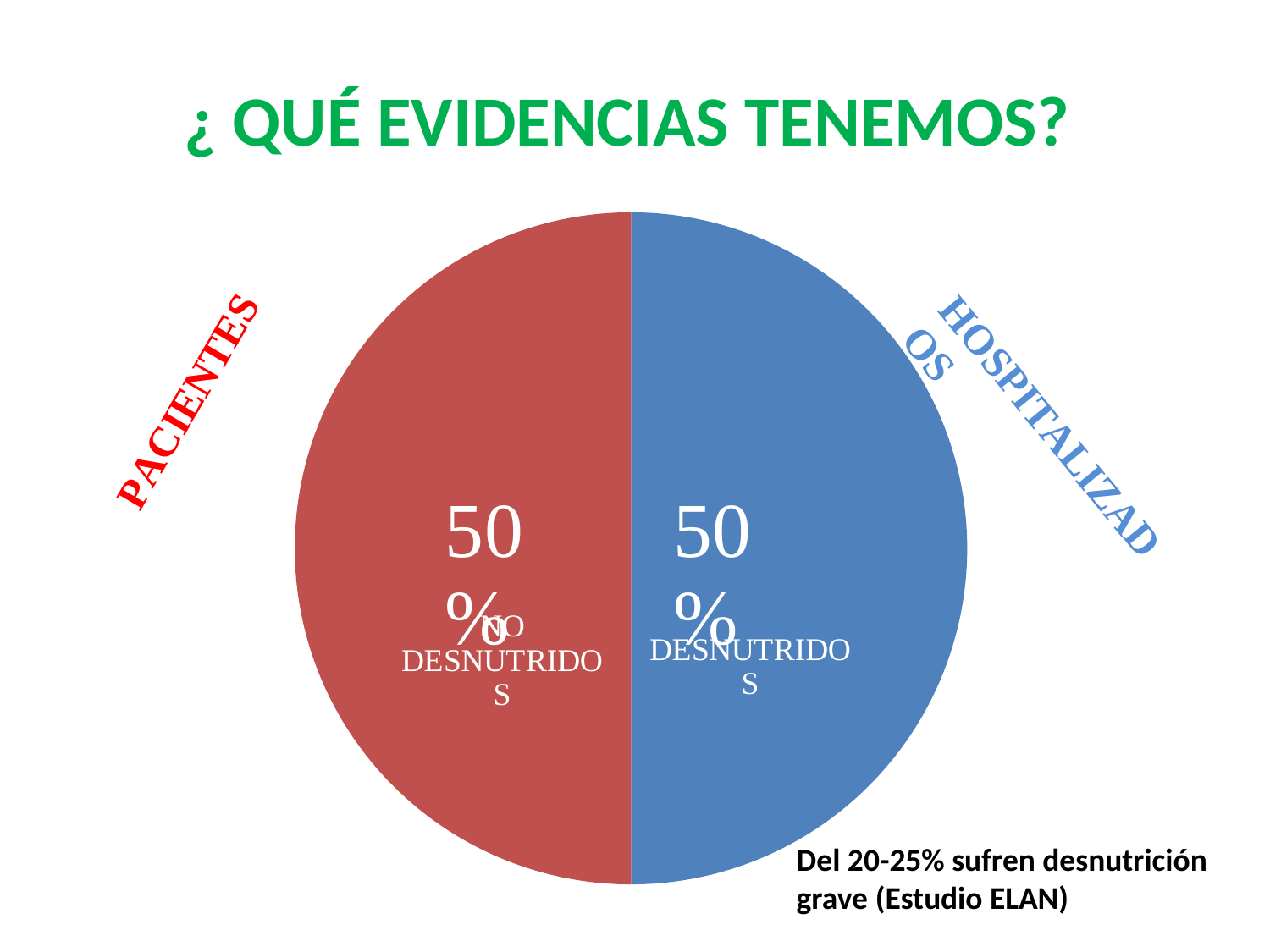
Is the DESNUTRIDOS slice larger, smaller, or the same size as the NO DESNUTRIDOS slice? the same size How many slices does the pie chart have? 2 What share of the pie does the NO DESNUTRIDOS slice represent? 50% What colour is the NO DESNUTRIDOS slice? red What kind of chart is shown on the slide? pie chart What percentage is shown for the NO DESNUTRIDOS slice? 50% What colour is the DESNUTRIDOS slice? blue What percentage is shown for the DESNUTRIDOS slice? 50% What is the total of the two slices in the pie chart? 100% What is the difference between the DESNUTRIDOS and NO DESNUTRIDOS percentages? 0%